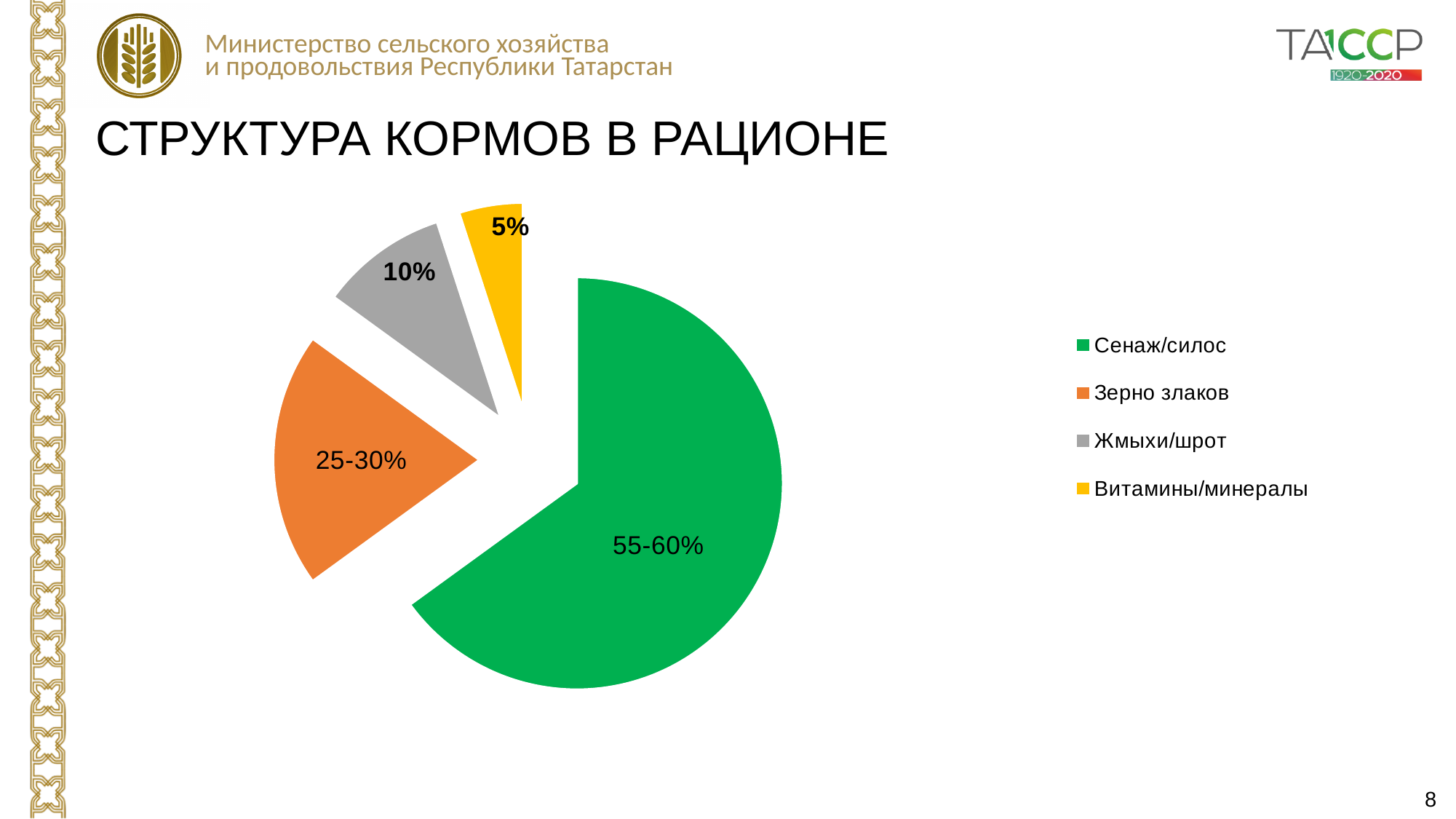
What share is shown for Зерно злаков? 25-30% Which is larger, the slice for Жмыхи/шрот or the slice for Витамины/минералы? Жмыхи/шрот What percentage is labelled for Жмыхи/шрот? 10% Which category has the largest slice of the pie? Сенаж/силос What percentage is labelled for Витамины/минералы? 5% What share of the ration does Сенаж/силос account for? 55-60% How many slices does the pie chart have? 4 What colour is the slice for Зерно злаков? Orange How many entries does the legend list? 4 By how many percentage points does Жмыхи/шрот exceed Витамины/минералы? 5% Which category has the smallest slice of the pie? Витамины/минералы What type of chart is shown on the slide? Pie chart